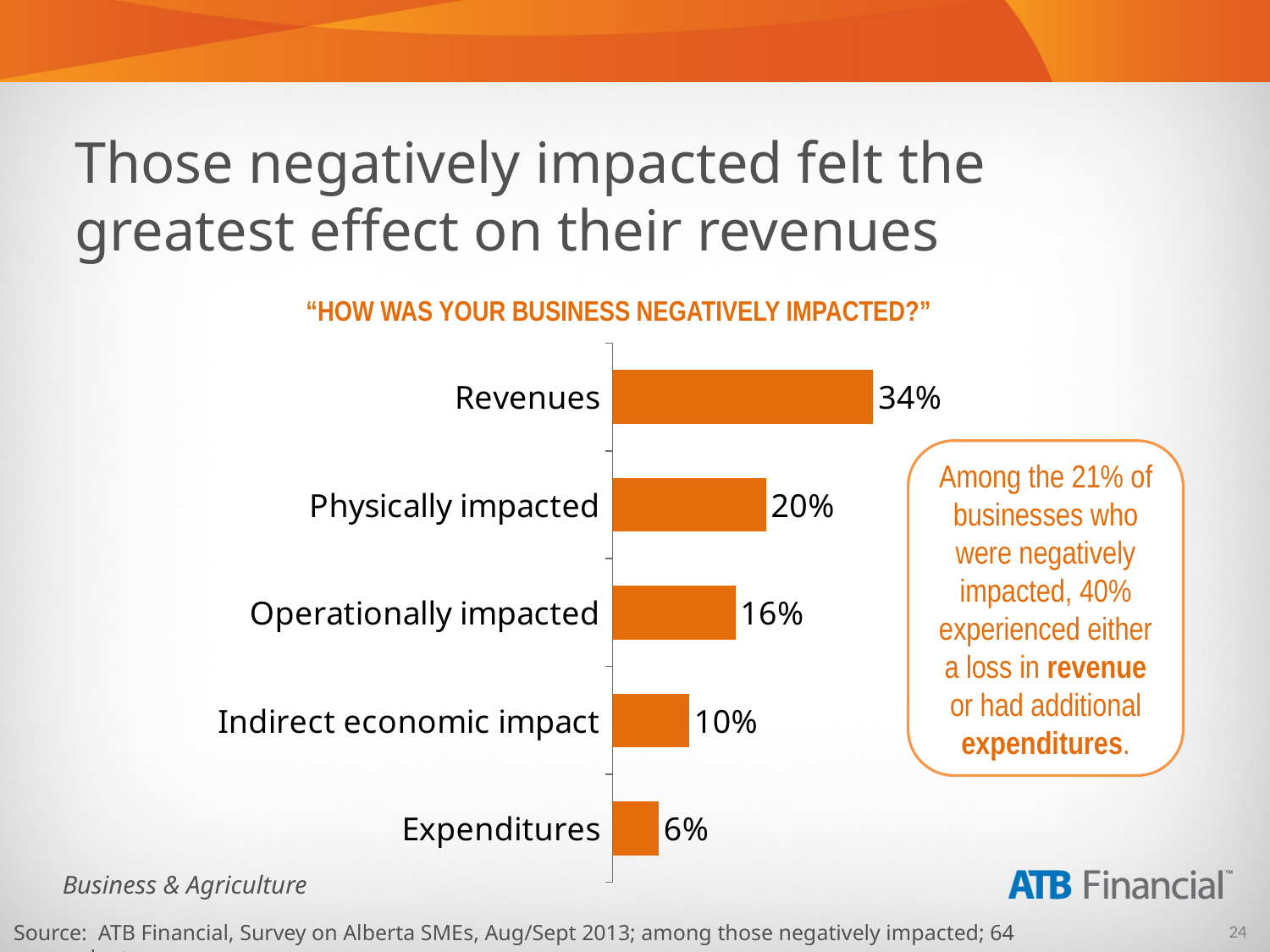
What is the title of the chart? "HOW WAS YOUR BUSINESS NEGATIVELY IMPACTED?" What is the value shown for Expenditures? 6% Which category has the lowest value? Expenditures What is the value shown for Physically impacted? 20% What percentage of businesses reported being negatively impacted on Revenues? 34% What is the difference between the values for Revenues and Expenditures? 28% How many categories are shown in the chart? 5 What kind of chart is shown on the slide? Bar chart Which category has the highest value? Revenues What is the value shown for Indirect economic impact? 10% What is the value shown for Operationally impacted? 16% Which is larger, the value for Physically impacted or Operationally impacted? Physically impacted